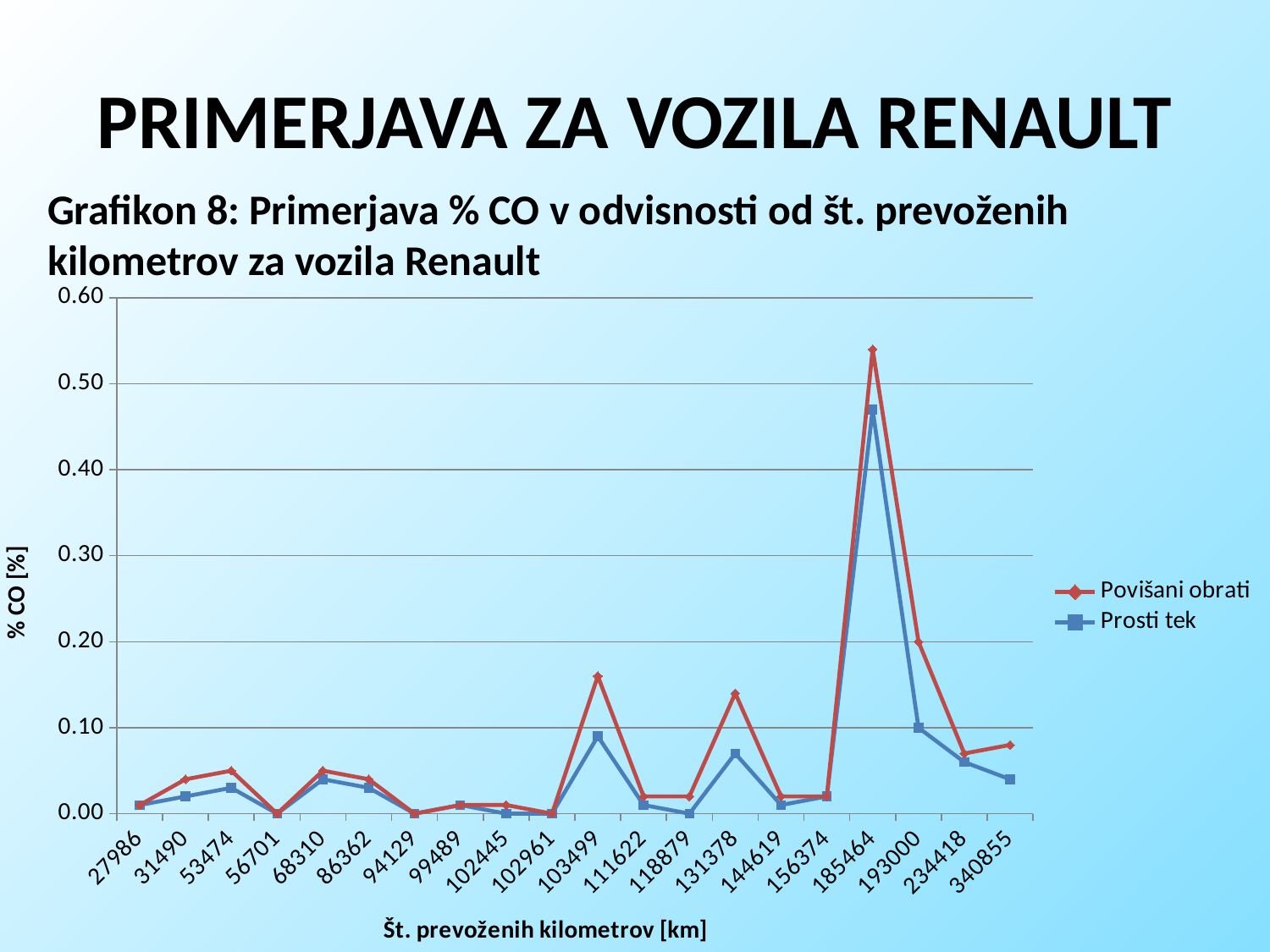
How many series does the legend list? 2 At which kilometre value does the Prosti tek series reach its highest % CO? 185464 What kind of chart is shown on the slide? line chart Is the Povišani obrati value at 185464 km greater or less than 0.50? greater At 103499 km, which series has the higher % CO, Povišani obrati or Prosti tek? Povišani obrati Is the Povišani obrati value at 103499 km greater or less than 0.10? greater Is the Prosti tek value at 185464 km greater or less than 0.50? less What is the title of the vertical axis? % CO [%] What is the title of the horizontal axis? Št. prevoženih kilometrov [km] At which kilometre value does the Povišani obrati series reach its highest % CO? 185464 How many kilometre categories are plotted along the x axis? 20 What is the Povišani obrati value at 56701 km? 0.00